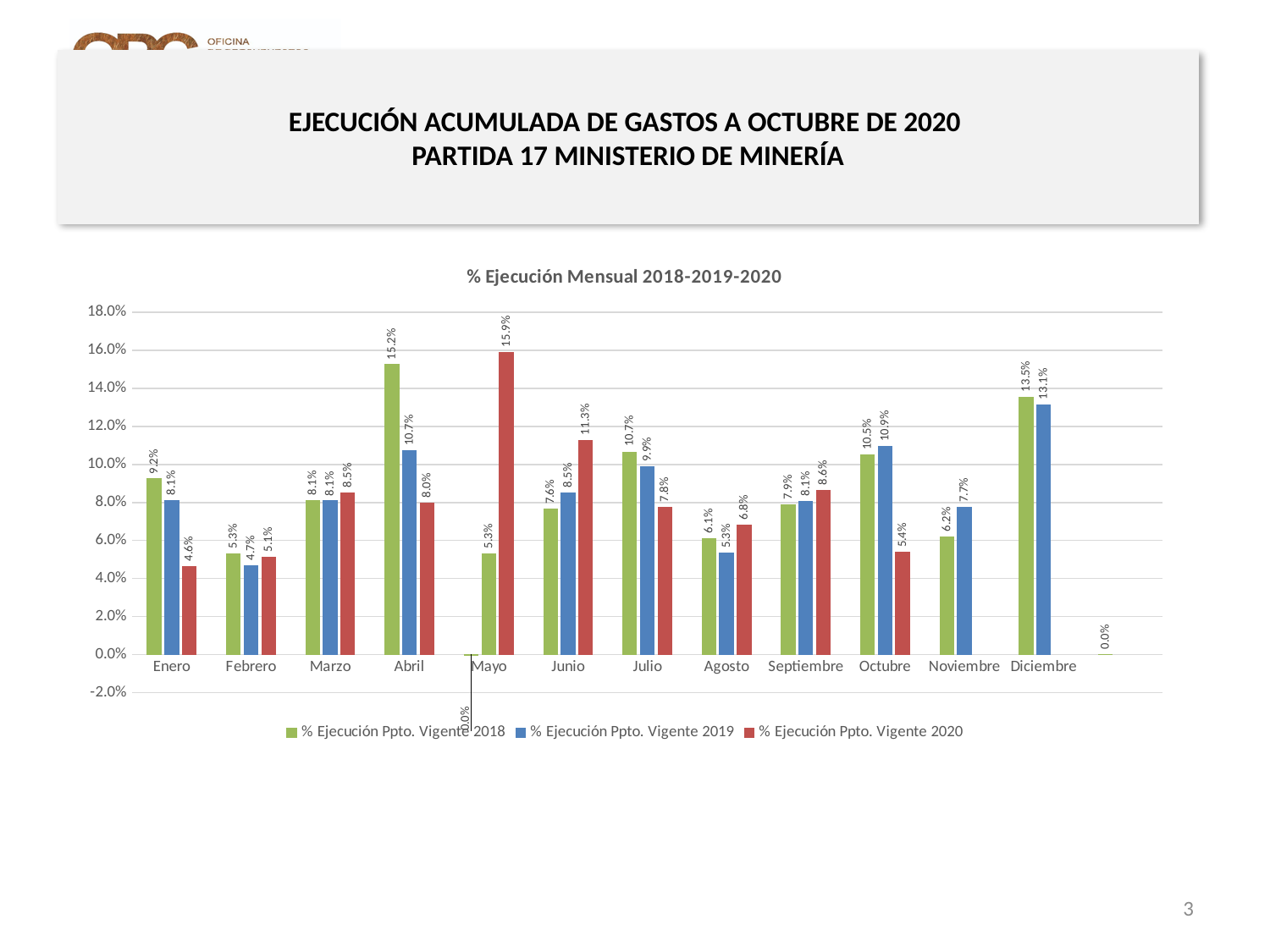
For Junio, which is larger: the 2019 value or the 2020 value? 2020 What is the difference between the 2019 and 2020 values for Octubre? 5.5 percentage points In which month is the % Ejecución Ppto. Vigente 2018 value highest? Abril In which month is the % Ejecución Ppto. Vigente 2020 value highest? Mayo How many series does the legend list? 3 What is the value of % Ejecución Ppto. Vigente 2020 for Octubre? 5.4% What is the value of % Ejecución Ppto. Vigente 2018 for Abril? 15.2% What is the title of the chart? % Ejecución Mensual 2018-2019-2020 What is the difference between the 2018 and 2019 values for Abril? 4.5 percentage points In which month is the % Ejecución Ppto. Vigente 2020 value lowest? Enero What kind of chart is shown on the slide? Bar chart What is the value of % Ejecución Ppto. Vigente 2019 for Diciembre? 13.1%